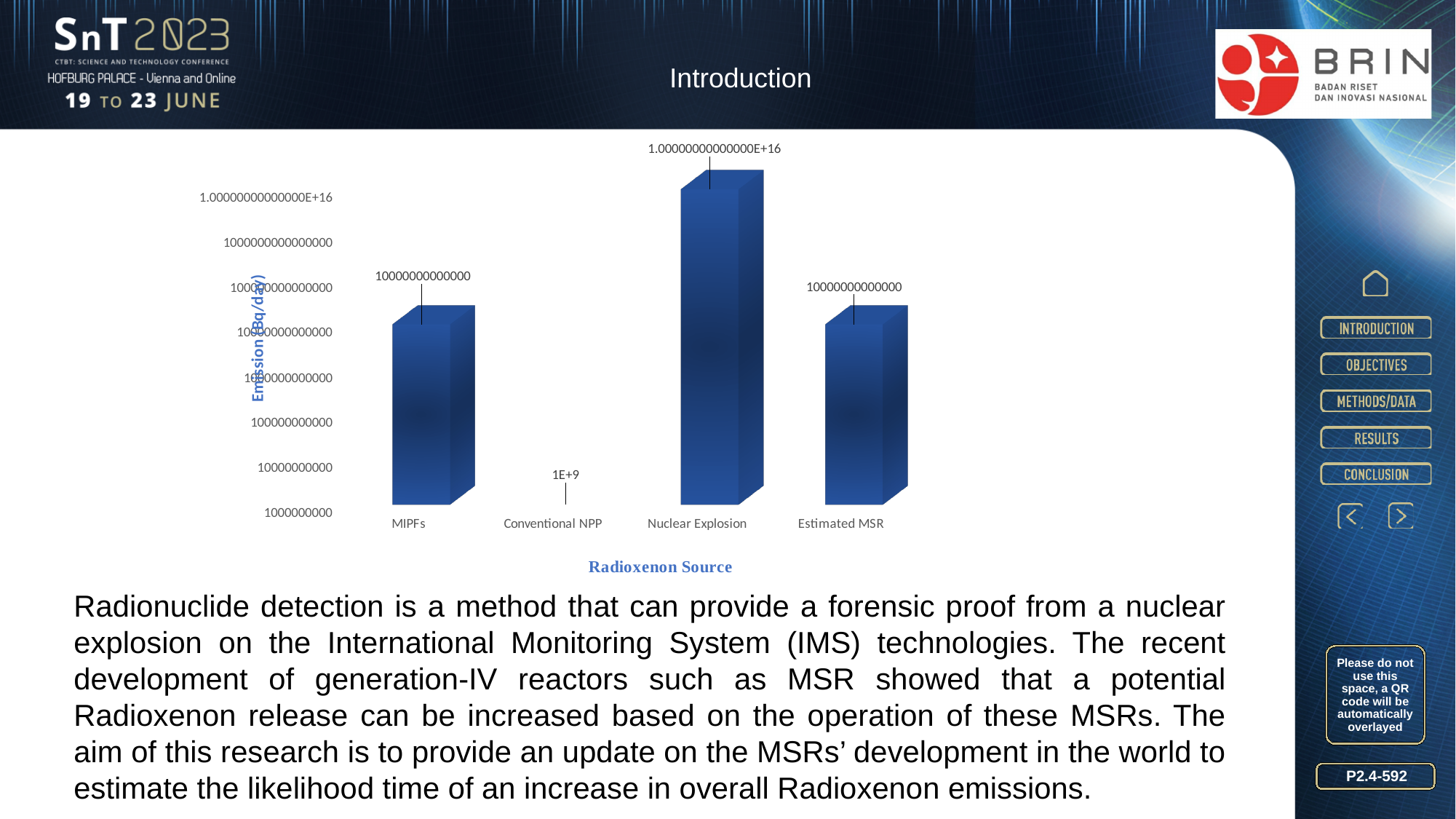
How many radioxenon sources are shown on the x axis? 4 Which radioxenon source has the highest emission? Nuclear Explosion What is the value for Estimated MSR? 10000000000000 Which radioxenon source has the lowest emission? Conventional NPP What is the value for Nuclear Explosion? 1.00000000000000E+16 What is the title of the y axis of the chart? Emission (Bq/day) What kind of chart is shown on the slide? bar chart Which is larger, the value for Nuclear Explosion or the value for Conventional NPP? Nuclear Explosion What is the title of the x axis of the chart? Radioxenon Source What is the value for Conventional NPP? 1E+9 What is the value for MIPFs? 10000000000000 Is the value for MIPFs greater or less than 1000000000000000? less